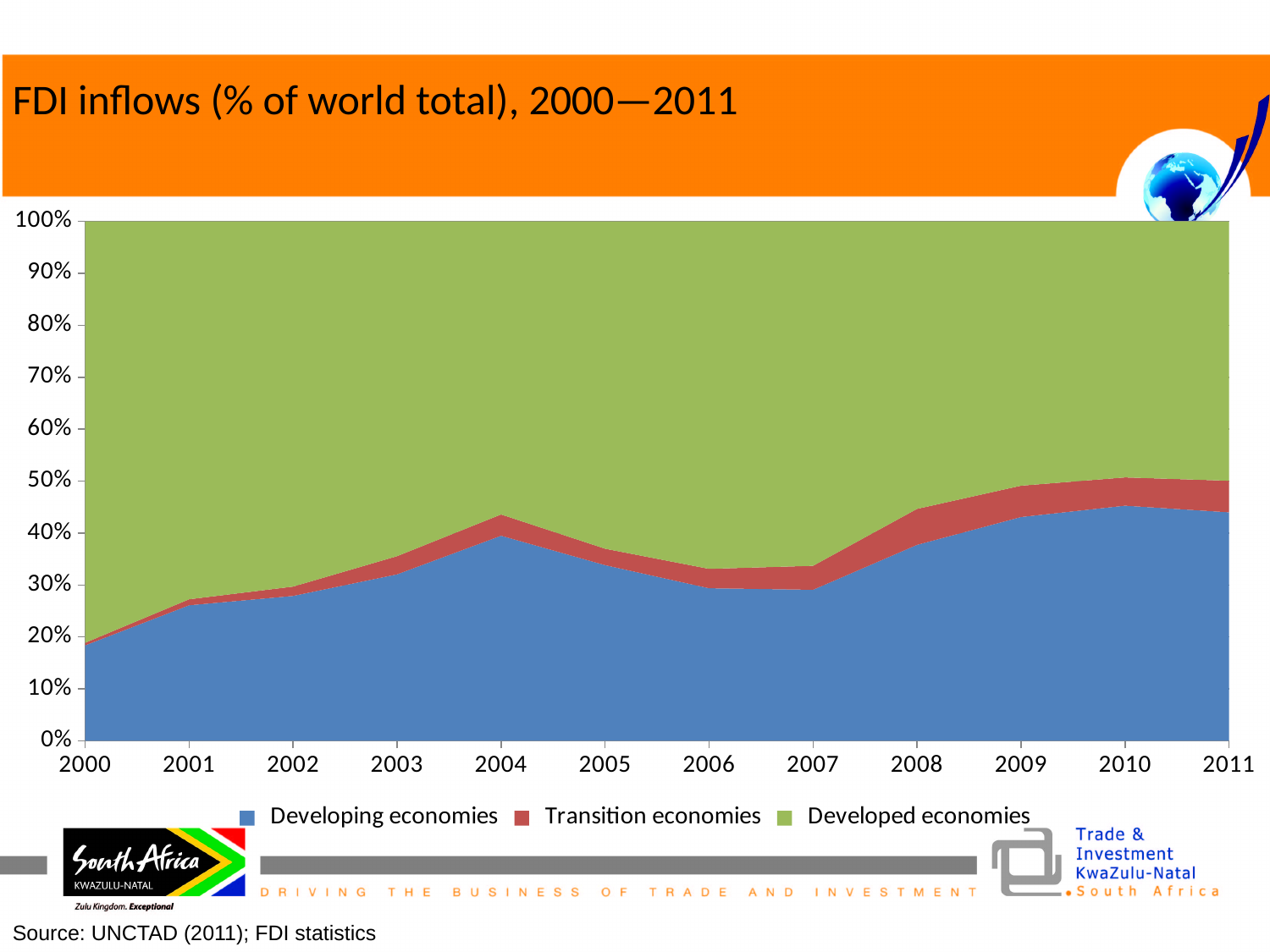
Is the share for Developed economies in 2006 greater or less than 60%? greater Does the share for Developing economies rise or fall between 2000 and 2011 overall? rise Is the share for Developing economies in 2010 greater or less than 40%? greater Which series has the largest share in 2000? Developed economies Is the share for Developing economies in 2002 greater or less than 30%? less How many series does the legend list? 3 Which series is shown in green? Developed economies What kind of chart is shown on the slide? Stacked area chart How many years are shown along the x axis? 12 What is the title of the chart? FDI inflows (% of world total), 2000—2011